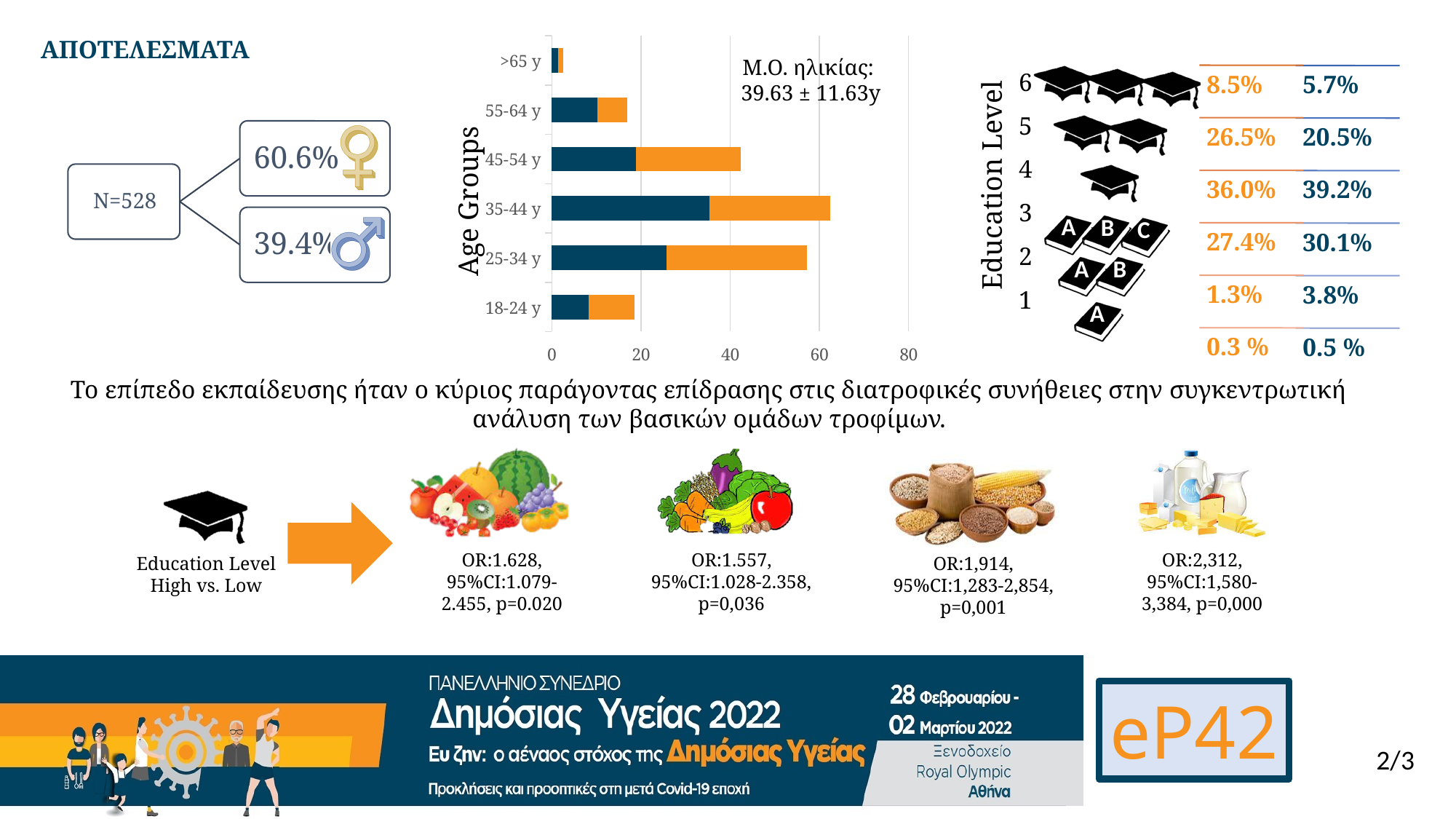
On the Age Groups chart, which bar is longer: 25-34 y or 45-54 y? 25-34 y How many age group categories are shown on the Age Groups chart? 6 On the Age Groups chart, is the total bar length for 25-34 y greater or less than 40? greater Which age group has the shortest bar on the Age Groups chart? >65 y On the Age Groups chart, is the total bar length for 55-64 y greater or less than 20? less On the Age Groups chart, is the total bar length for 35-44 y greater or less than 40? greater Which age group has the longest bar on the Age Groups chart? 35-44 y What type of chart is used to show the age groups? bar chart What mean age (Μ.Ο. ηλικίας) is annotated on the Age Groups chart? 39.63 ± 11.63y What is the label of the vertical axis on the bar chart? Age Groups On the Age Groups chart, which bar is longer: 45-54 y or 55-64 y? 45-54 y